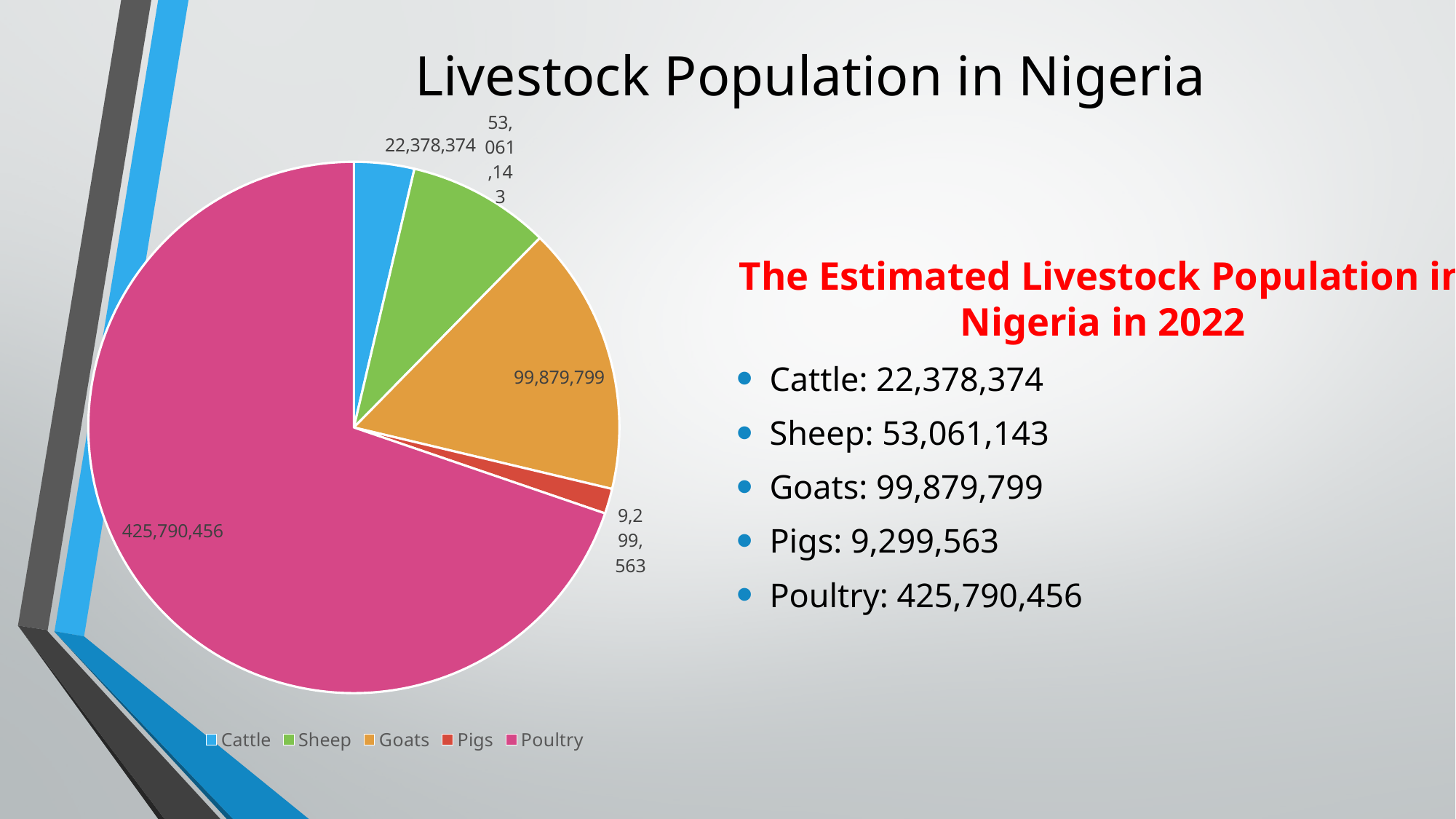
What is the value shown for Pigs in the pie chart? 9,299,563 What is the value shown for Goats in the pie chart? 99,879,799 Which category has the largest slice in the pie chart? Poultry Which is larger in the pie chart, Sheep or Goats? Goats How many categories does the pie chart show? 5 What is the value shown for Cattle in the pie chart? 22,378,374 What is the difference between the Goats value and the Sheep value? 46,818,656 What is the difference between the Cattle value and the Pigs value? 13,078,811 What kind of chart is shown on the slide? Pie chart What is the value shown for Poultry in the pie chart? 425,790,456 What colour is the Poultry slice in the pie chart? Pink Which category has the smallest slice in the pie chart? Pigs